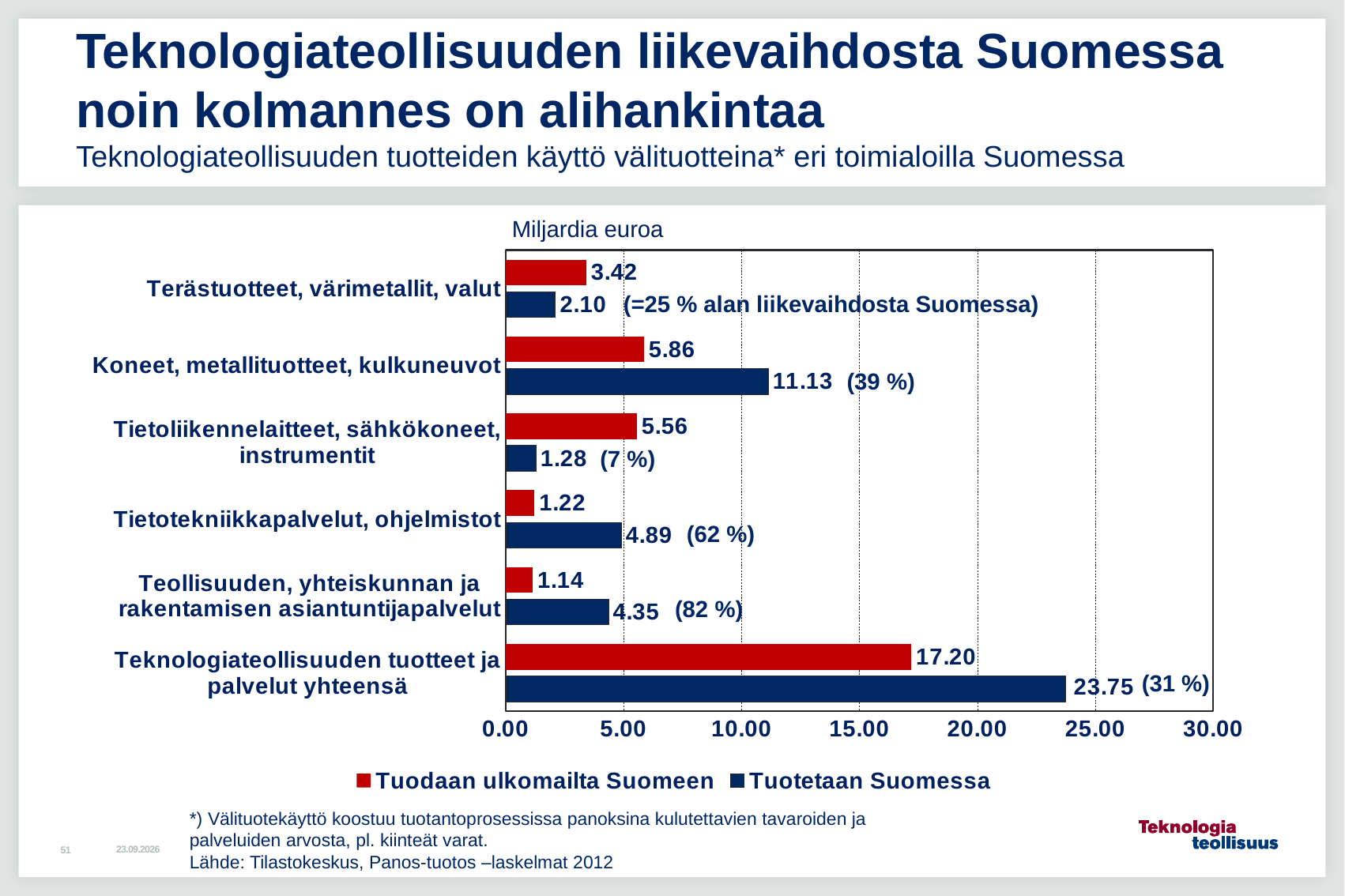
How many series does the legend list? 2 What percentage of the sector's turnover in Finland is shown next to the "Tuotetaan Suomessa" bar for "Teollisuuden, yhteiskunnan ja rakentamisen asiantuntijapalvelut"? 82 % What is the value of "Tuotetaan Suomessa" for "Koneet, metallituotteet, kulkuneuvot"? 11.13 What is the difference between "Tuotetaan Suomessa" and "Tuodaan ulkomailta Suomeen" for "Tietotekniikkapalvelut, ohjelmistot"? 3.67 What unit is stated above the chart? Miljardia euroa How many categories are shown on the chart? 6 What is the value of "Tuodaan ulkomailta Suomeen" for "Tietoliikennelaitteet, sähkökoneet, instrumentit"? 5.56 Which category has the lowest value for "Tuodaan ulkomailta Suomeen"? Teollisuuden, yhteiskunnan ja rakentamisen asiantuntijapalvelut For "Terästuotteet, värimetallit, valut", which is larger: "Tuodaan ulkomailta Suomeen" or "Tuotetaan Suomessa"? Tuodaan ulkomailta Suomeen What kind of chart is shown on the slide? bar chart What is the value of "Tuotetaan Suomessa" for "Teknologiateollisuuden tuotteet ja palvelut yhteensä"? 23.75 Which category has the highest value for "Tuotetaan Suomessa"? Teknologiateollisuuden tuotteet ja palvelut yhteensä